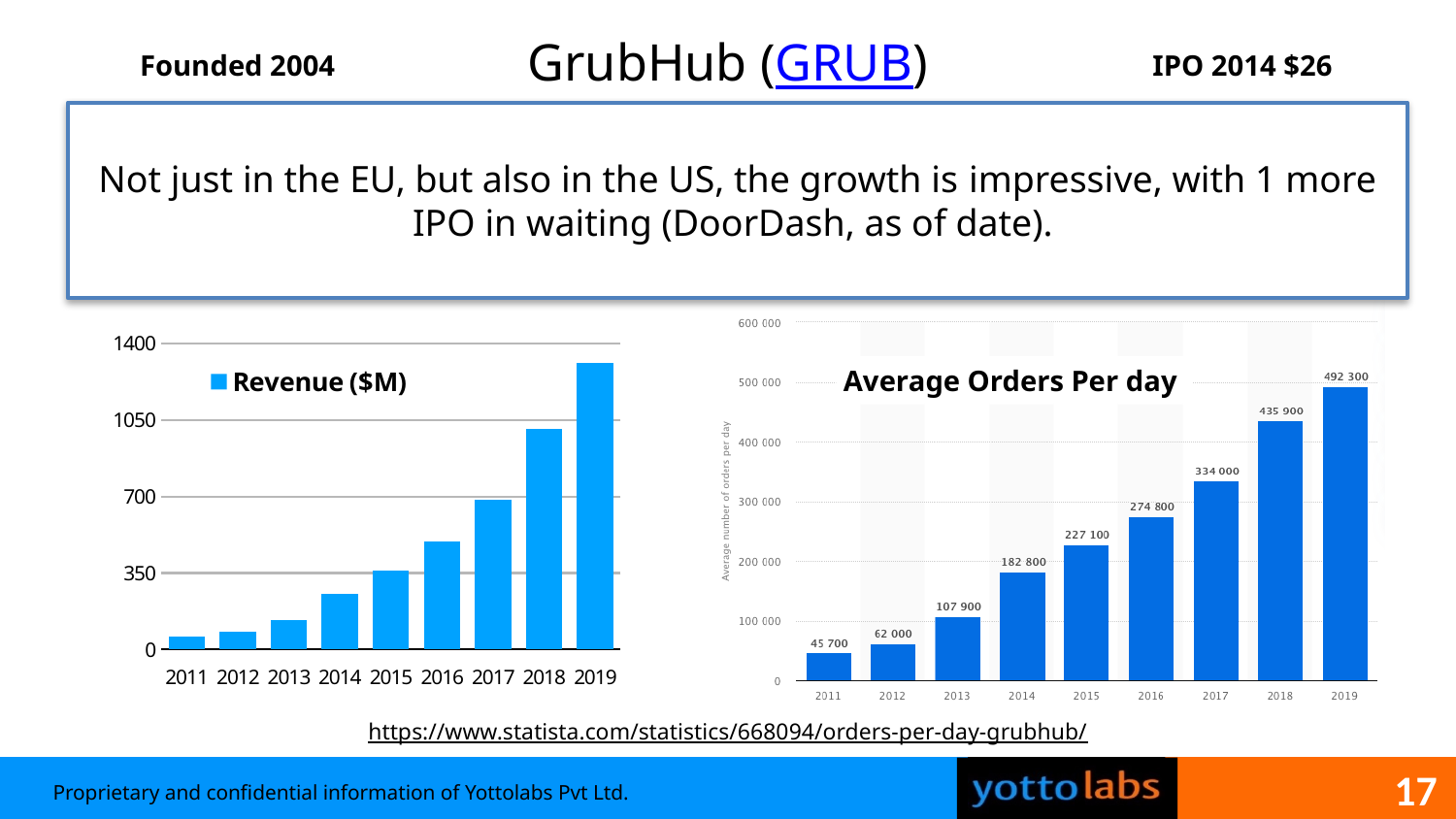
In the Average Orders Per day chart, what is the value for 2014? 182 800 In the Average Orders Per day chart, what is the difference between the values for 2018 and 2017? 101 900 In the Average Orders Per day chart, which year has the lowest value? 2011 In the Average Orders Per day chart, how many years are shown? 9 In the Average Orders Per day chart, what is the value for 2019? 492 300 In the Revenue ($M) chart on the left, is the value for 2016 greater or less than 700? less In the Average Orders Per day chart, which year has the highest value? 2019 What kind of chart is the Revenue ($M) chart on the left? bar chart In the Revenue ($M) chart on the left, is the value for 2019 greater or less than 1050? greater In the Average Orders Per day chart, which is larger, the value for 2015 or the value for 2016? 2016 In the Average Orders Per day chart, do the values rise or fall from 2011 to 2019? rise In the Average Orders Per day chart, what is the value for 2011? 45 700